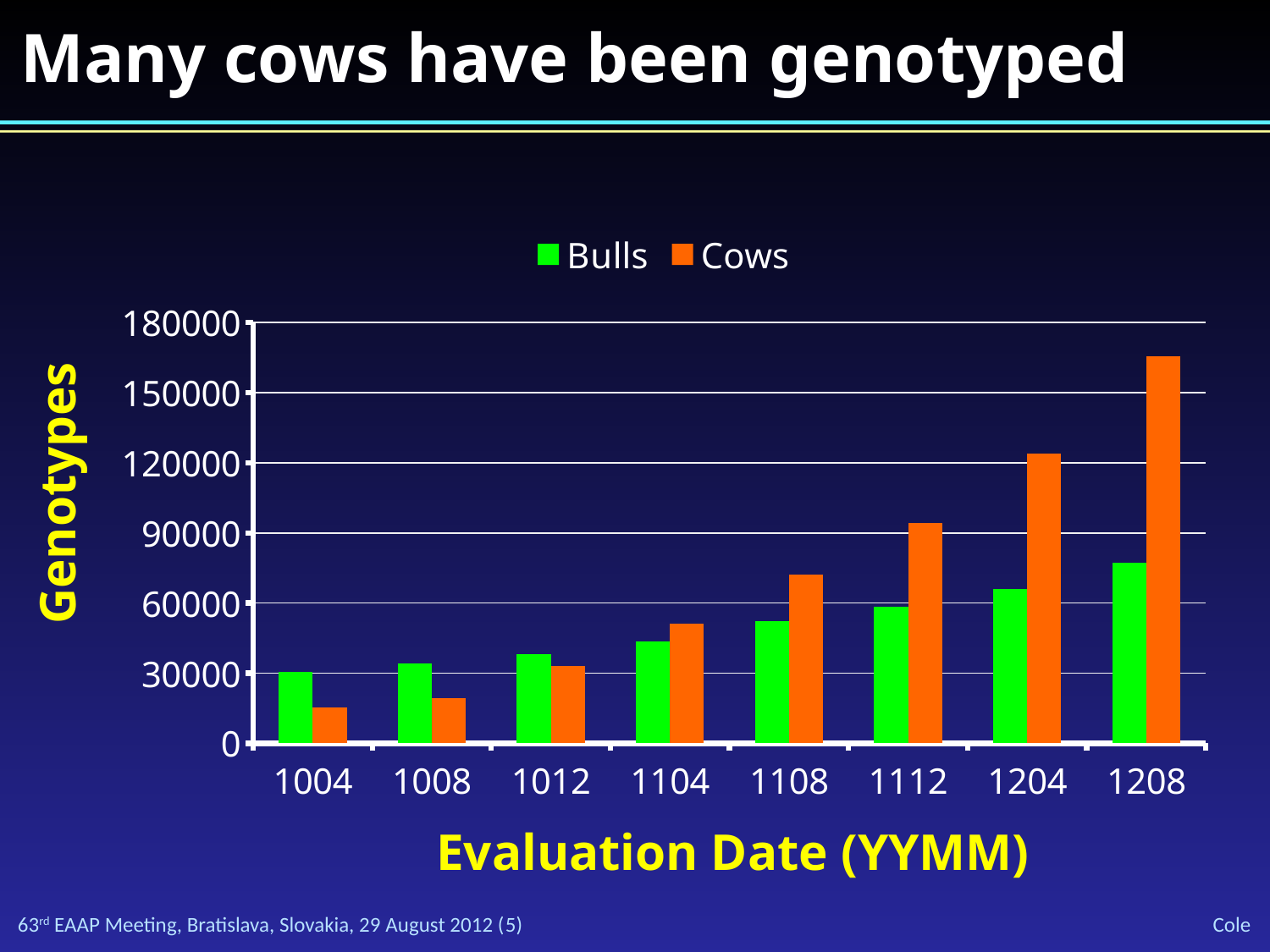
At which evaluation date is the Bulls value highest? 1208 At which evaluation date is the Cows value lowest? 1004 How many evaluation dates are shown on the x axis? 8 At evaluation date 1004, which series has the larger value, Bulls or Cows? Bulls What is the label of the y axis? Genotypes How many series does the legend list? 2 Is the Bulls value for 1204 greater or less than 90000? less At evaluation date 1208, which series has the larger value, Bulls or Cows? Cows At which evaluation date is the Cows value highest? 1208 What kind of chart is shown on the slide? bar chart Is the Cows value for 1208 greater or less than 150000? greater Do the Cows values generally rise or fall from 1004 to 1208? rise